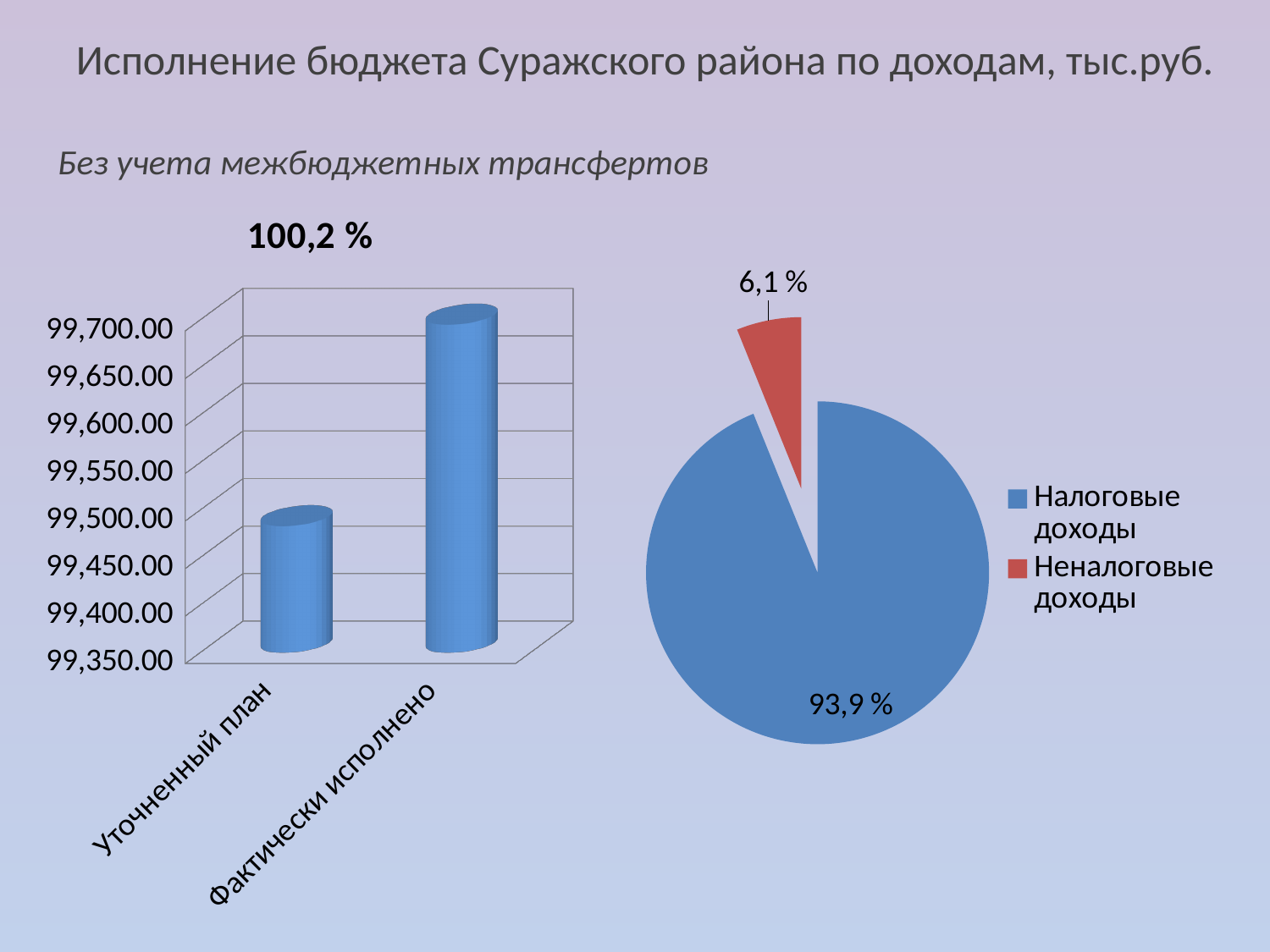
In the bar chart on the left, is the value for Уточненный план greater or less than 99,550.00? less In the pie chart on the right, what share is shown for Налоговые доходы? 93,9 % In the bar chart on the left, which category has the higher bar? Фактически исполнено How many entries does the legend of the pie chart on the right list? 2 What percentage figure is printed above the bar chart on the left? 100,2 % In the bar chart on the left, is the value for Фактически исполнено greater or less than 99,650.00? greater What kind of chart is the chart on the left of the slide? bar chart In the pie chart on the right, what share is shown for Неналоговые доходы? 6,1 % What kind of chart is the chart on the right of the slide? pie chart In the bar chart on the left, how many categories are shown on the x axis? 2 In the pie chart on the right, which slice is the largest? Налоговые доходы In the bar chart on the left, which category has the lower bar? Уточненный план